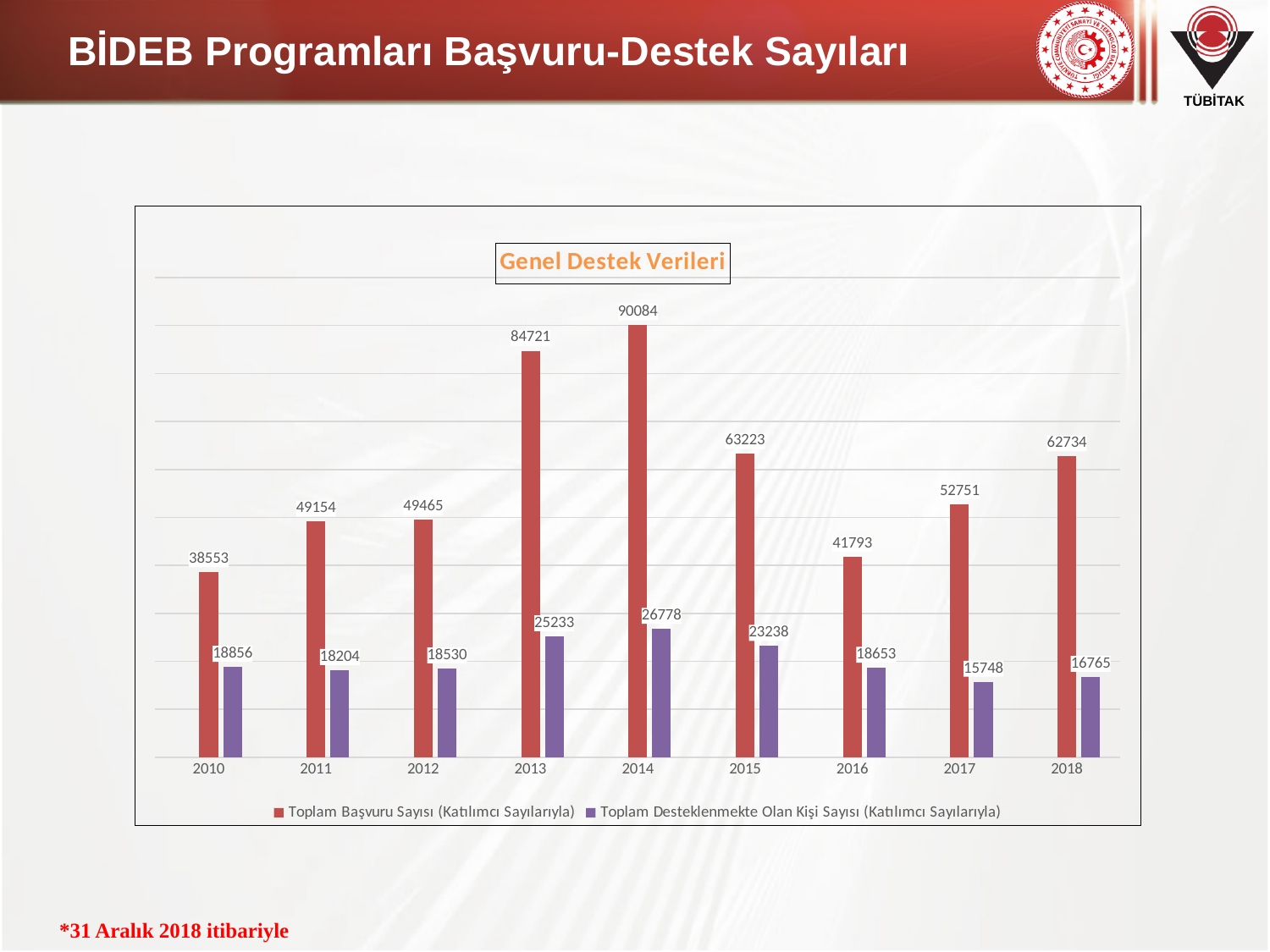
Which year has the highest Toplam Başvuru Sayısı? 2014 Which is larger: the Toplam Başvuru Sayısı for 2015 or for 2018? 2015 What is the Toplam Desteklenmekte Olan Kişi Sayısı value for 2013? 25233 How many series does the legend list? 2 What is the Toplam Başvuru Sayısı value for 2018? 62734 What kind of chart is shown on the slide? Bar chart How many years are shown on the x axis? 9 What is the difference between the Toplam Başvuru Sayısı values for 2014 and 2013? 5363 What is the title of the chart? Genel Destek Verileri Which year has the lowest Toplam Başvuru Sayısı? 2010 What is the Toplam Başvuru Sayısı value for 2014? 90084 Which year has the lowest Toplam Desteklenmekte Olan Kişi Sayısı? 2017